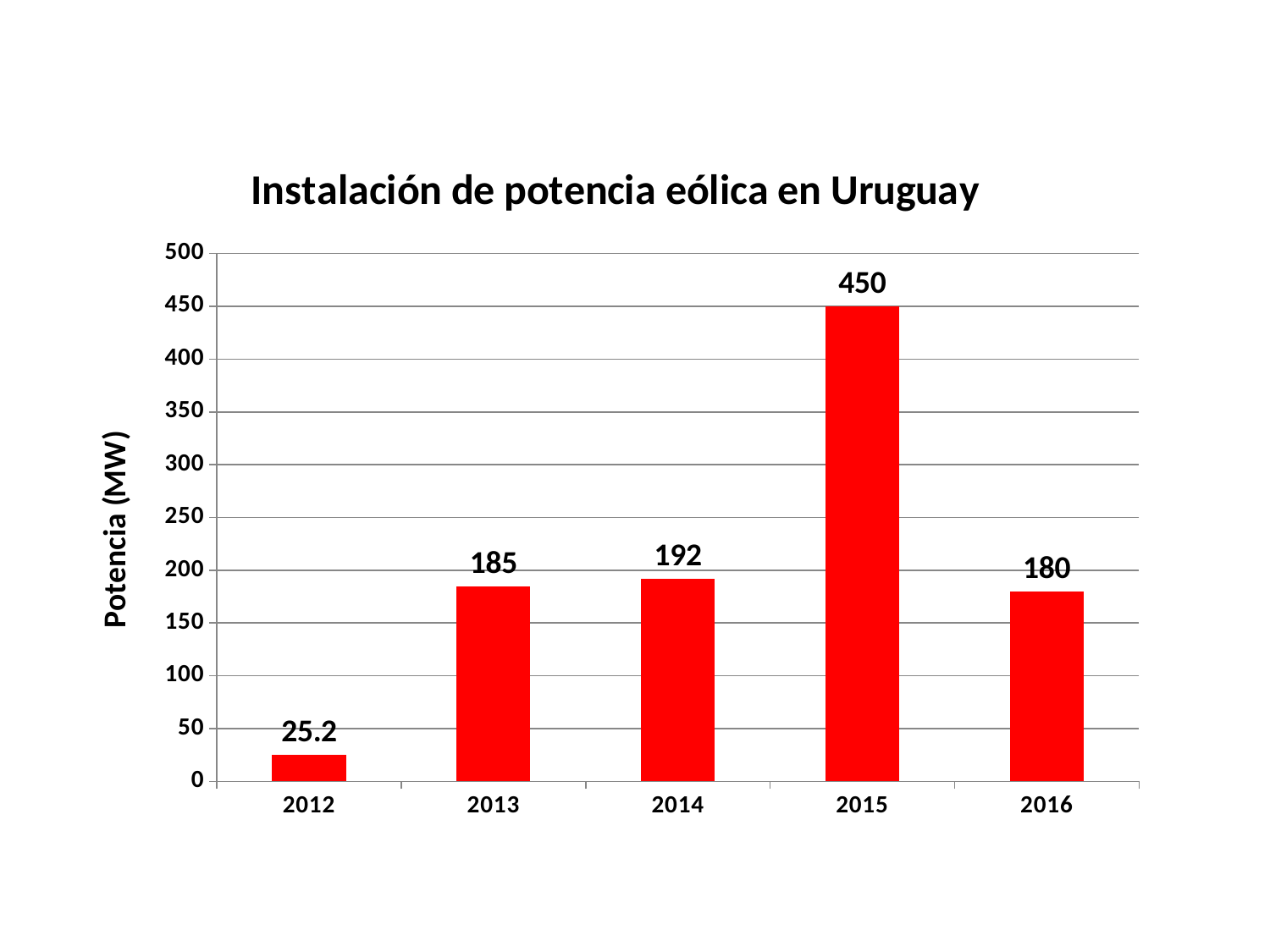
What is the value for 2016? 180 What is the difference between the values for 2013 and 2012? 159.8 Is the value for 2013 greater or less than 150? greater What is the title of the chart? Instalación de potencia eólica en Uruguay Which year has the lowest value? 2012 Which year has the highest value? 2015 What is the value for 2012? 25.2 How many years are shown on the x axis? 5 Which is larger, the value for 2014 or the value for 2016? 2014 What kind of chart is this? bar chart What is the value for 2015? 450 What is the difference between the values for 2015 and 2014? 258